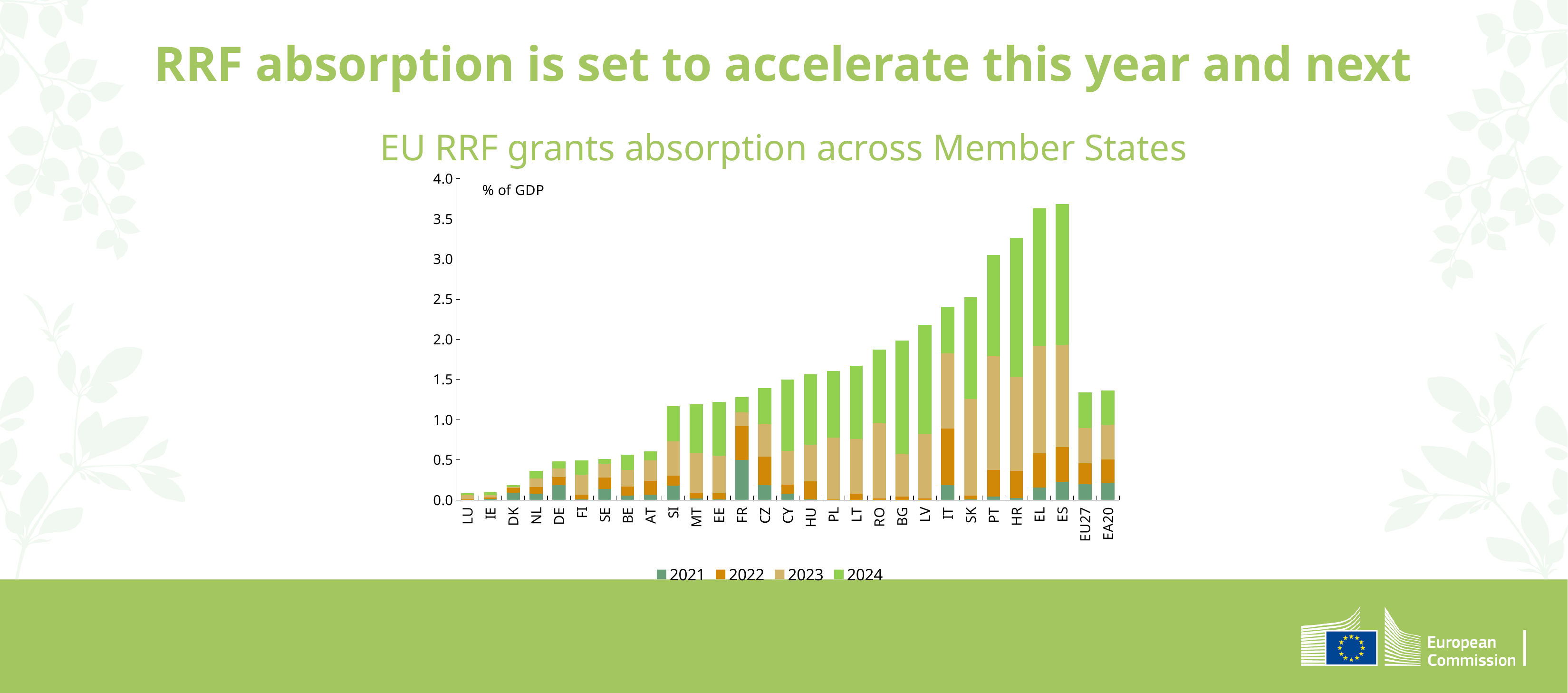
Is the total value for IT greater or less than 2.0? greater Is the total value for LU greater or less than 0.5? less What kind of chart is shown on the slide? Stacked bar chart Which has the larger total bar, HR or IT? HR Which has the larger total bar, ES or PT? ES How many series does the legend list? 4 How many categories are shown along the x axis? 29 Do the total bar heights for the Member States generally rise or fall from left to right along the x axis? Rise What unit is indicated on the chart's vertical axis? % of GDP Is the total value for ES greater or less than 3.5? greater